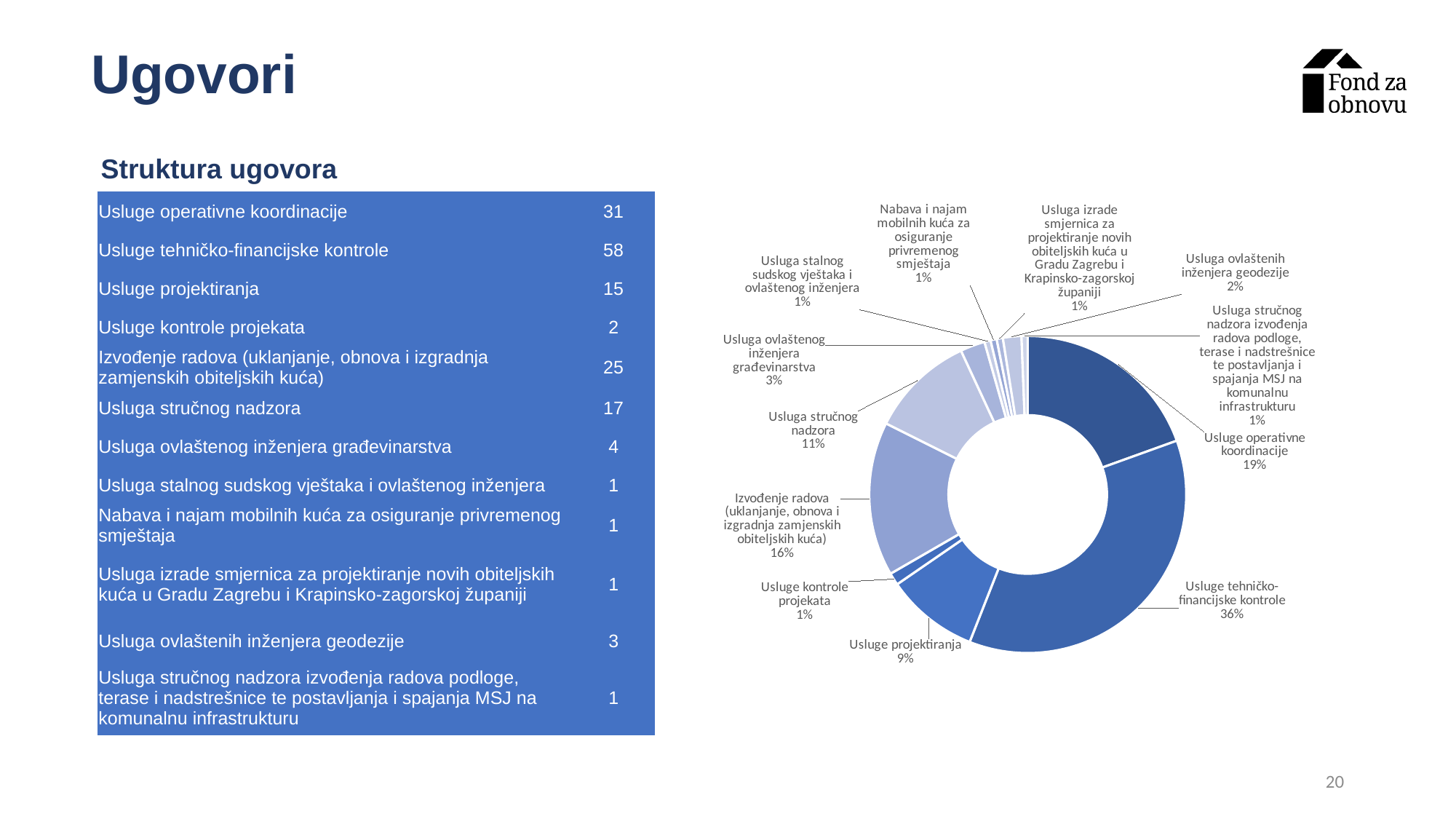
Which category has the largest share in the doughnut chart? Usluge tehničko-financijske kontrole What share of the doughnut chart does Usluge tehničko-financijske kontrole represent? 36% Which has the larger share in the chart: Usluge operativne koordinacije or Usluga stručnog nadzora? Usluge operativne koordinacije What percentage is shown for Usluge projektiranja in the chart? 9% What is the difference in percentage points between the shares of Usluge tehničko-financijske kontrole and Usluge operativne koordinacije? 17 percentage points How many categories (slices) are shown in the doughnut chart? 12 What kind of chart is shown on the slide? doughnut chart What percentage is shown for Usluga ovlaštenih inženjera geodezije in the chart? 2% What percentage is shown for Izvođenje radova (uklanjanje, obnova i izgradnja zamjenskih obiteljskih kuća) in the chart? 16% What percentage is shown for Usluga stručnog nadzora in the chart? 11% What percentage is shown for Usluga ovlaštenog inženjera građevinarstva in the chart? 3% What share of the doughnut chart does Usluge operativne koordinacije represent? 19%